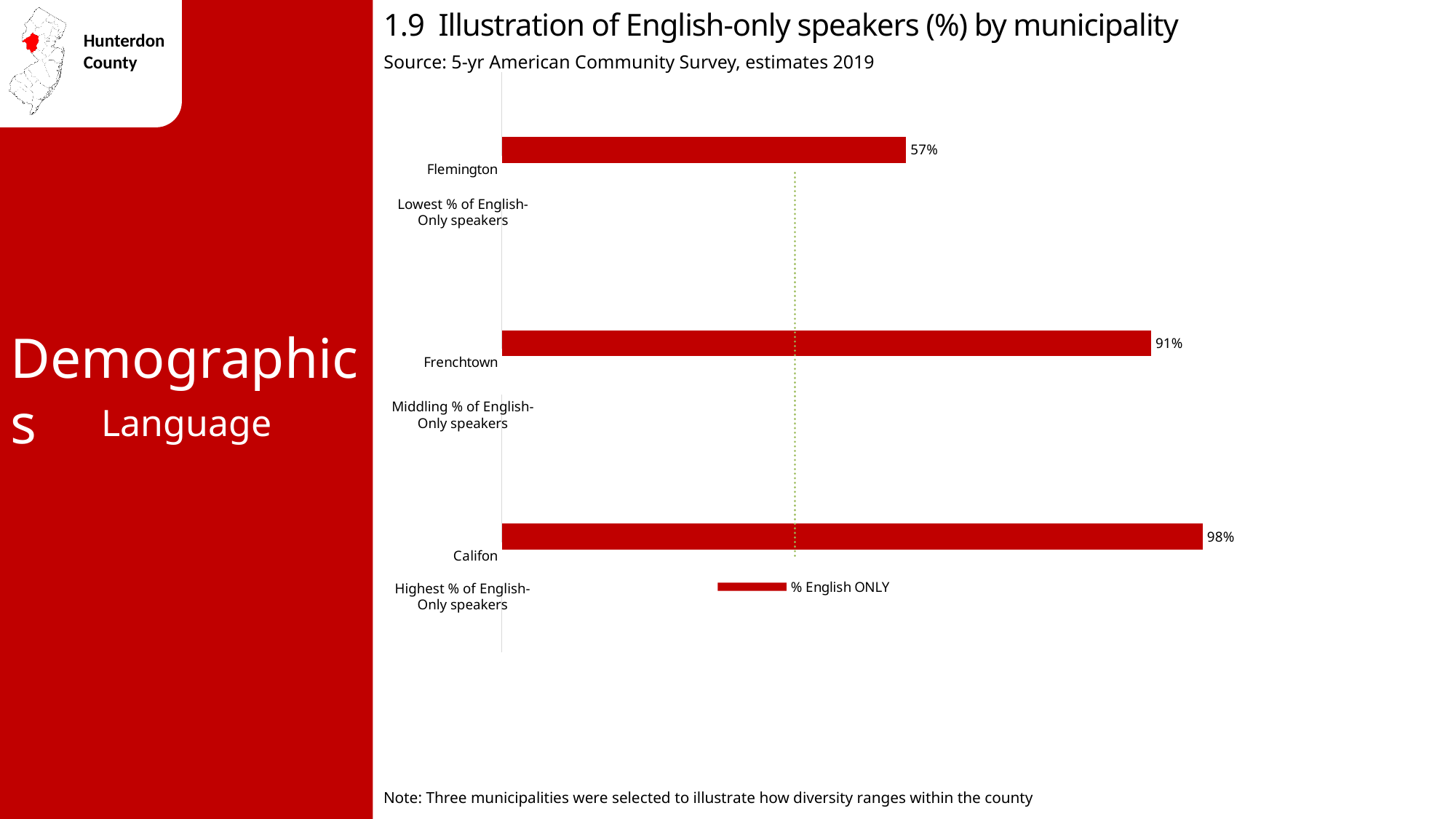
What percentage of English-only speakers is shown for Flemington? 57% How many series does the legend list? 1 Which municipality has the lowest percentage of English-only speakers? Flemington How many municipalities are shown in the chart? 3 What is the difference in percentage points between Frenchtown and Flemington? 34 What percentage of English-only speakers is shown for Califon? 98% Which has a higher percentage of English-only speakers, Frenchtown or Flemington? Frenchtown What type of chart is shown on the slide? Bar chart What is the legend entry for the series shown in the chart? % English ONLY Which municipality has the highest percentage of English-only speakers? Califon What is the difference in percentage points between Califon and Flemington? 41 What percentage of English-only speakers is shown for Frenchtown? 91%